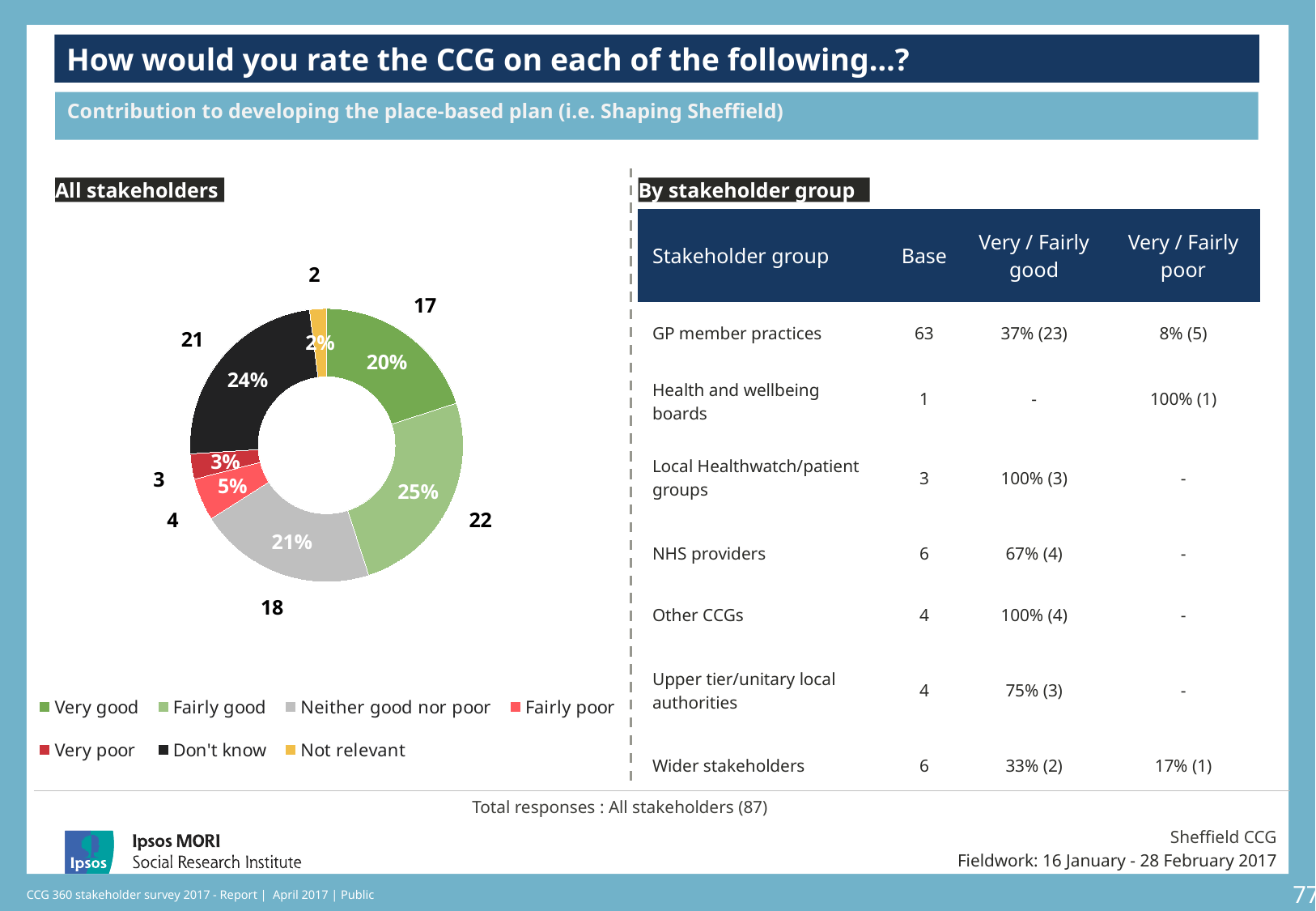
How many respondents rated the CCG 'Very good' in the All stakeholders chart? 17 What percentage of all stakeholders answered 'Don't know'? 24% What percentage of all stakeholders rated the CCG 'Fairly good'? 25% How many categories does the legend of the All stakeholders chart list? 7 How many respondents answered 'Neither good nor poor' in the All stakeholders chart? 18 In the All stakeholders chart, which is larger: 'Don't know' or 'Neither good nor poor'? Don't know In the All stakeholders chart, what is the difference in percentage points between 'Fairly good' and 'Very good'? 5 percentage points Which category has the smallest share in the All stakeholders chart? Not relevant Which category has the largest share in the All stakeholders chart? Fairly good What kind of chart is shown under 'All stakeholders'? Pie chart (donut) What share of the All stakeholders chart is 'Very poor'? 3% What colour represents 'Not relevant' in the All stakeholders chart? Yellow